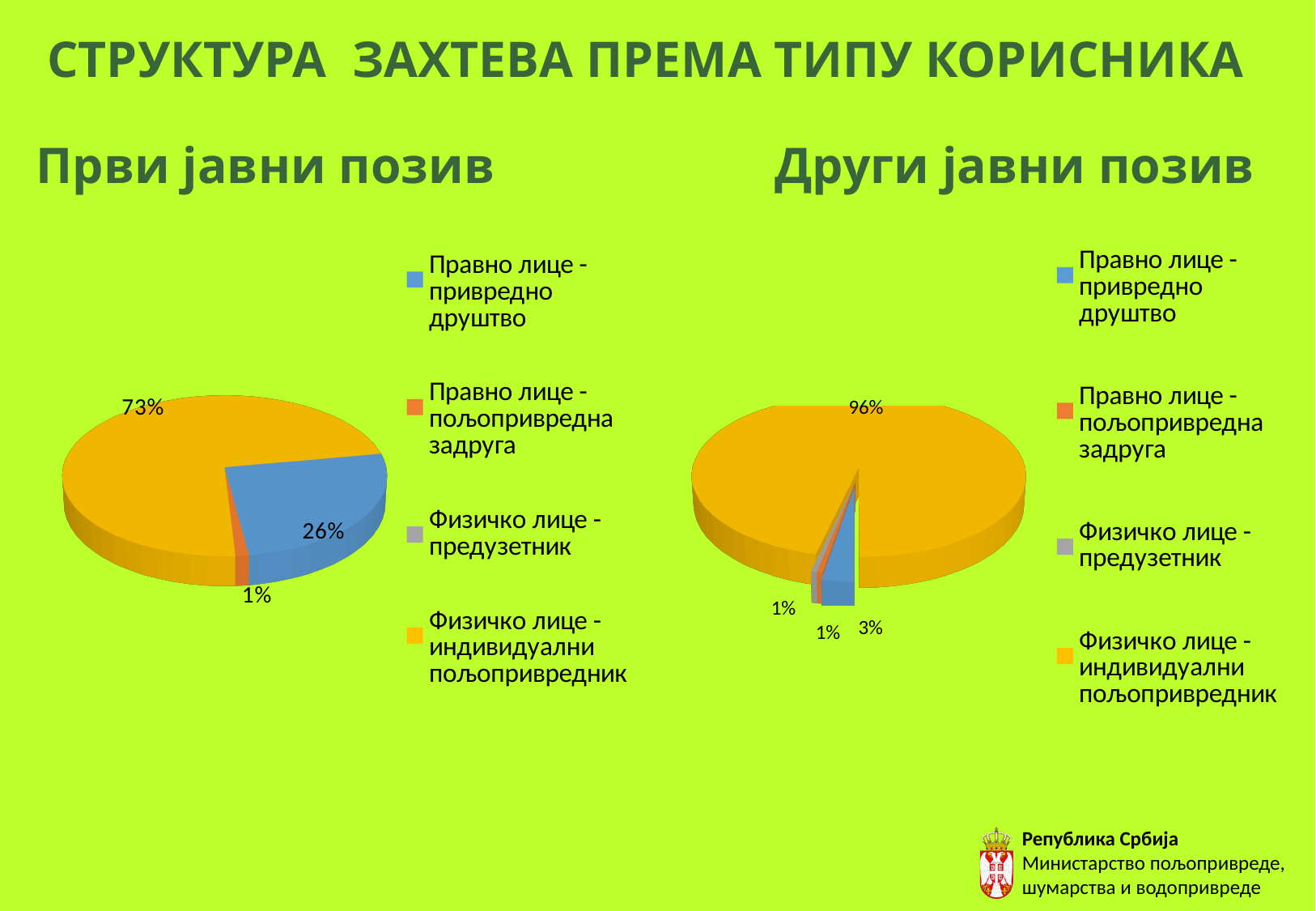
In the chart titled "Други јавни позив", what share of requests came from "Физичко лице - индивидуални пољопривредник"? 96% What type of chart is used for "Други јавни позив"? Pie chart In the chart titled "Први јавни позив", what is the difference in percentage points between the "Физичко лице - индивидуални пољопривредник" slice and the "Правно лице - привредно друштво" slice? 47 In the chart titled "Први јавни позив", which category has the largest slice? Физичко лице - индивидуални пољопривредник In the chart titled "Други јавни позив", which category has the largest slice? Физичко лице - индивидуални пољопривредник In the chart titled "Први јавни позив", what share of requests came from "Правно лице - привредно друштво"? 26% In the legend of the chart titled "Други јавни позив", which colour represents "Правно лице - привредно друштво"? Blue How many entries does the legend of the chart titled "Први јавни позив" list? 4 In the chart titled "Први јавни позив", what share of requests came from "Физичко лице - индивидуални пољопривредник"? 73% In the chart titled "Други јавни позив", what share of requests came from "Правно лице - привредно друштво"? 3% Which chart shows a larger share for "Правно лице - привредно друштво", "Први јавни позив" or "Други јавни позив"? Први јавни позив In the chart titled "Први јавни позив", what share of requests came from "Правно лице - пољопривредна задруга"? 1%